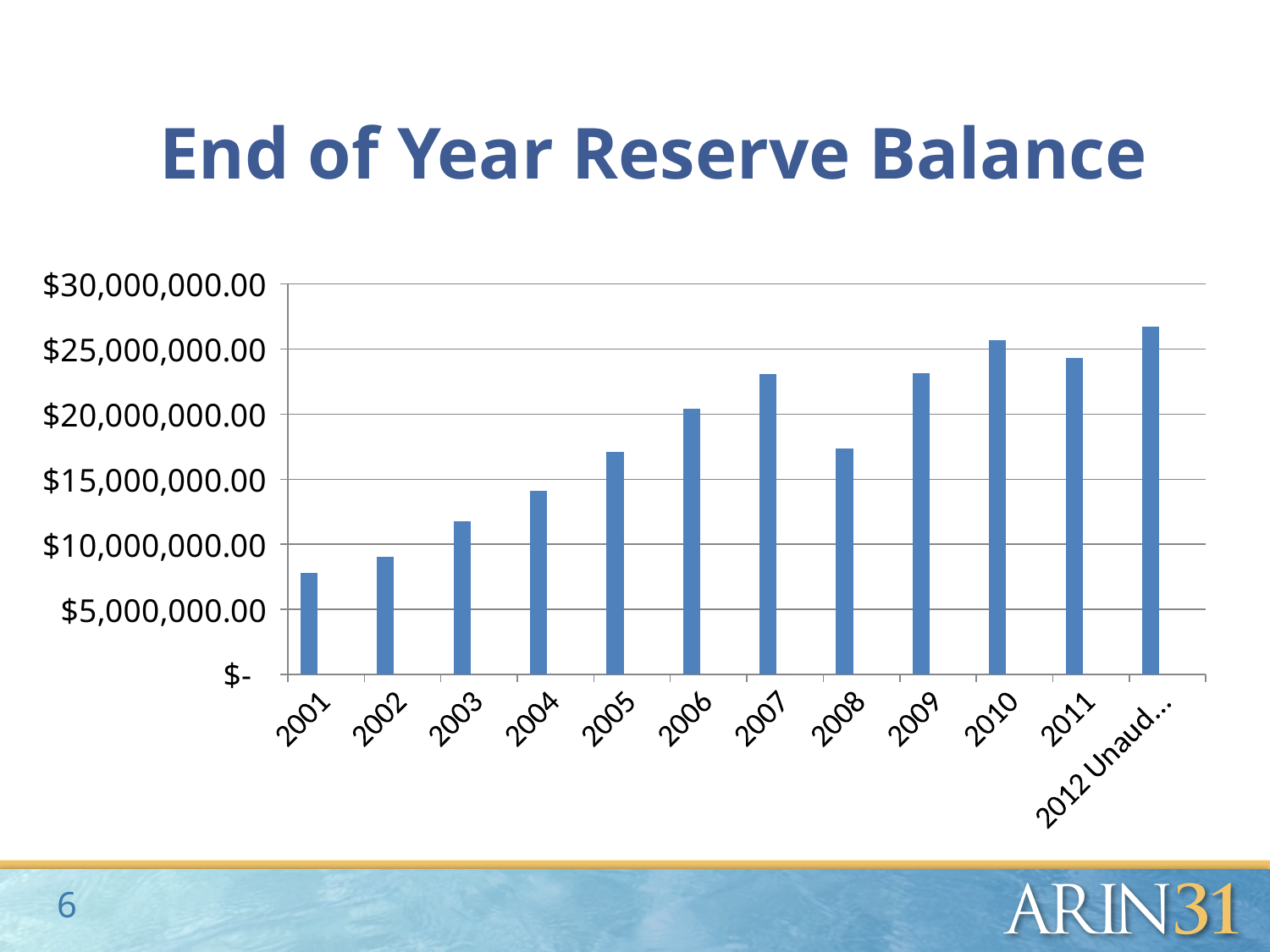
Is the value for 2008 greater or less than $20,000,000.00? less Is the value for 2004 greater or less than $15,000,000.00? less Which year has the lowest end of year reserve balance? 2001 Which is larger, the reserve balance for 2007 or for 2008? 2007 Which is larger, the reserve balance for 2010 or for 2011? 2010 Is the value for 2010 greater or less than $25,000,000.00? greater How many bars (years) are plotted in the chart? 12 What kind of chart is shown on the slide? bar chart Overall, do the reserve balances rise or fall from 2001 to the last year shown? rise What is the title of the chart? End of Year Reserve Balance